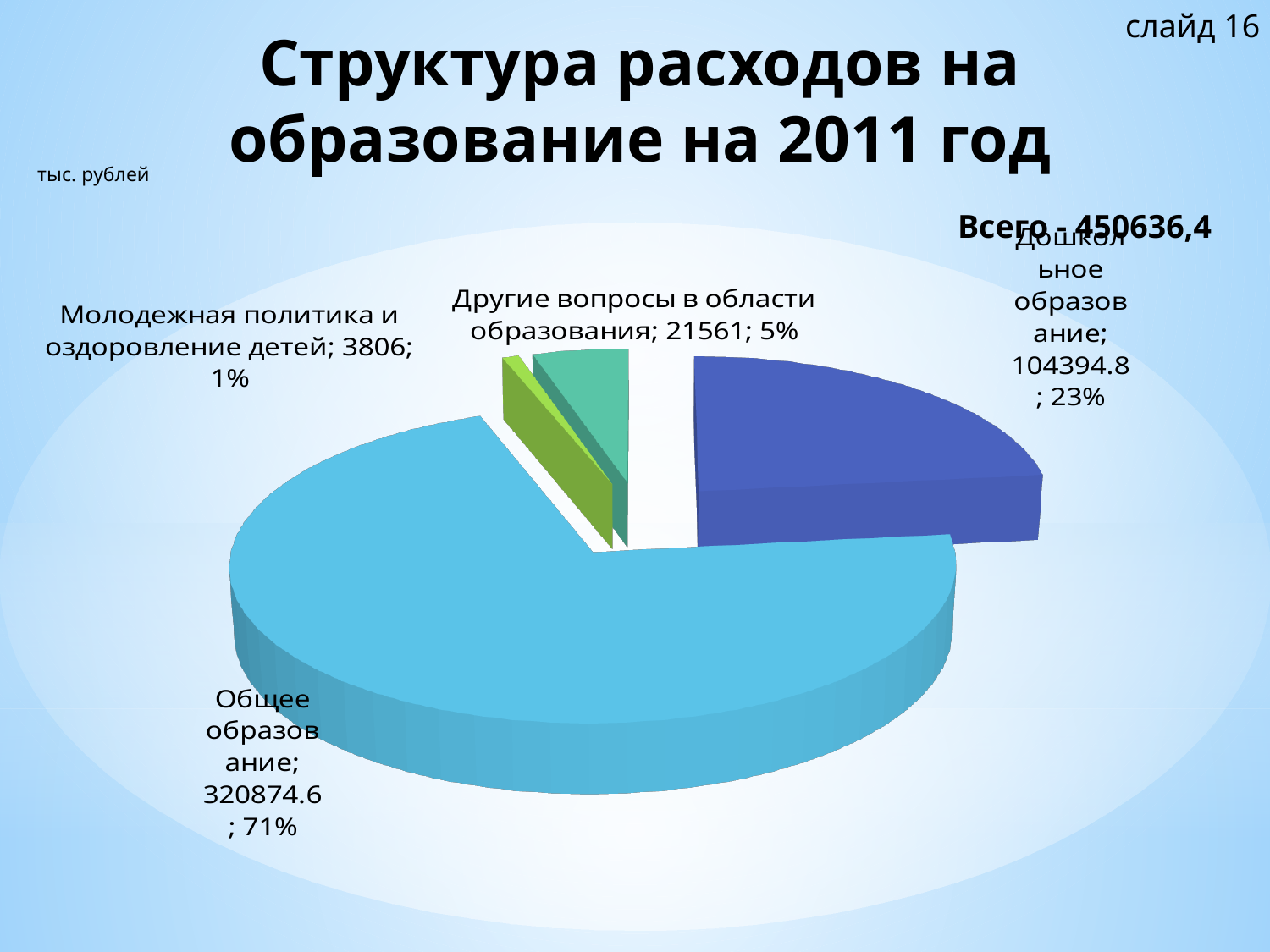
What is the value for Общее образование? 320874.6 What share of the pie does Другие вопросы в области образования represent? 5% How many slices does the pie chart have? 4 What share of the pie does Дошкольное образование represent? 23% What kind of chart is shown on the slide? pie chart What is the value for Другие вопросы в области образования? 21561 What is the value for Молодежная политика и оздоровление детей? 3806 Which is larger: the value for Другие вопросы в области образования or Молодежная политика и оздоровление детей? Другие вопросы в области образования What is the difference between the values for Общее образование and Дошкольное образование? 216479.8 Which category has the smallest share of the pie? Молодежная политика и оздоровление детей Which category has the largest share of the pie? Общее образование What is the value for Дошкольное образование? 104394.8